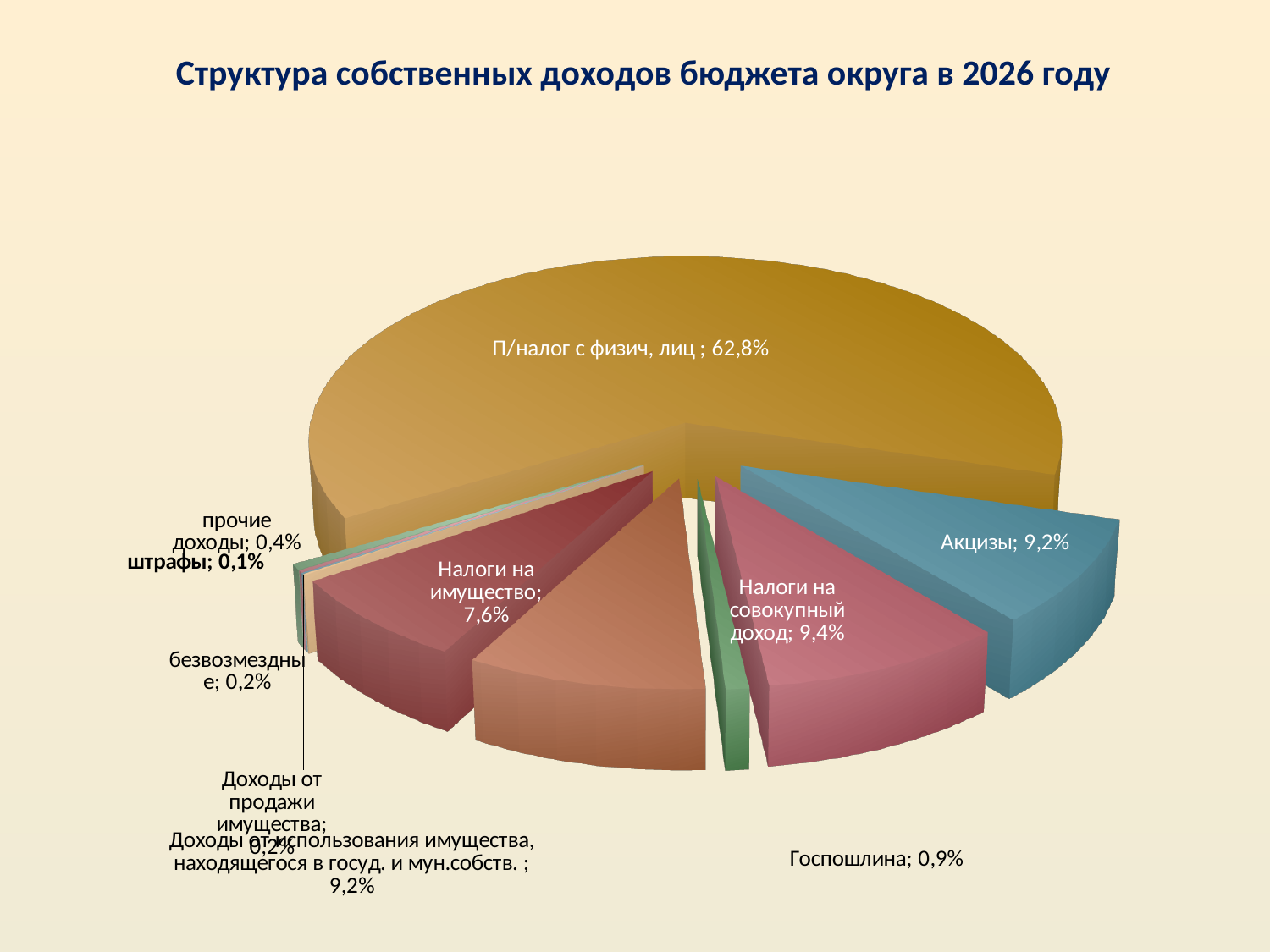
What is the share for П/налог с физич, лиц? 62,8% What is the share for Налоги на имущество? 7,6% What kind of chart is shown on the slide? pie chart What is the difference between the shares of Налоги на совокупный доход and Налоги на имущество? 1,8% What is the share for Госпошлина? 0,9% Which category has the smallest share of the pie? штрафы Which is larger: the share for Налоги на совокупный доход or the share for Акцизы? Налоги на совокупный доход What is the share for Налоги на совокупный доход? 9,4% What is the title of the chart? Структура собственных доходов бюджета округа в 2026 году What is the share for Акцизы? 9,2% Which category has the largest share of the pie? П/налог с физич, лиц What is the share for штрафы? 0,1%